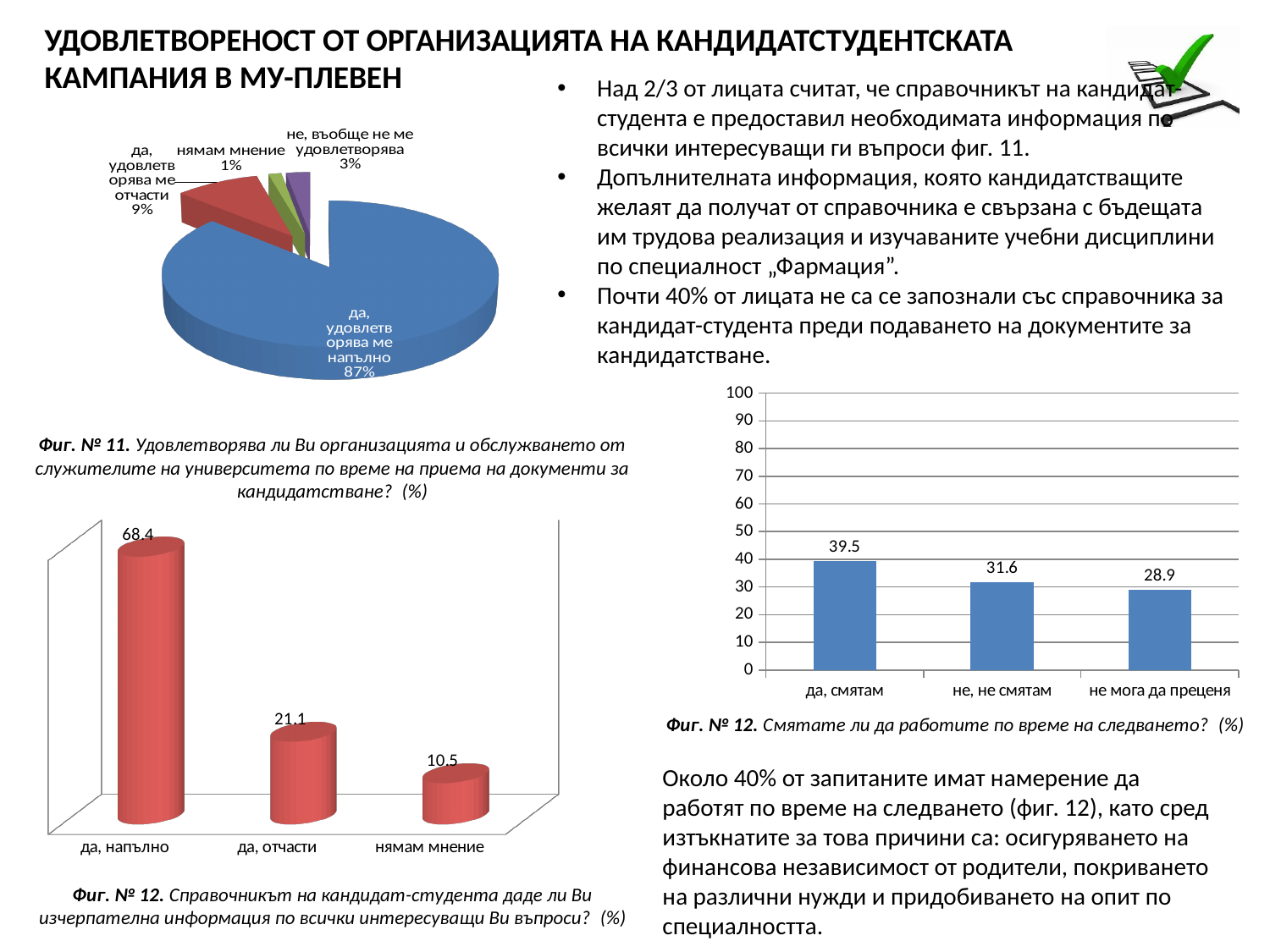
In the pie chart at the top left of the slide, what share is labelled for "да, удовлетворява ме напълно"? 87% In the bar chart at the bottom left of the slide, what is the difference between the values for "да, напълно" and "да, отчасти"? 47.3 How many slices does the pie chart at the top left of the slide have? 4 What kind of chart is shown at the bottom left of the slide? bar chart In the pie chart at the top left of the slide, what share is labelled for "да, удовлетворява ме отчасти"? 9% In the bar chart on the right of the slide, do the values rise or fall from left to right? fall In the bar chart on the right of the slide, which category has the highest value? да, смятам In the pie chart at the top left of the slide, which category has the smallest share? нямам мнение In the bar chart on the right of the slide, what is the value for "не, не смятам"? 31.6 In the bar chart on the right of the slide, is the value for "не мога да преценя" greater or less than 30? less In the bar chart at the bottom left of the slide, what is the value for "нямам мнение"? 10.5 In the bar chart at the bottom left of the slide, what is the value for "да, напълно"? 68.4